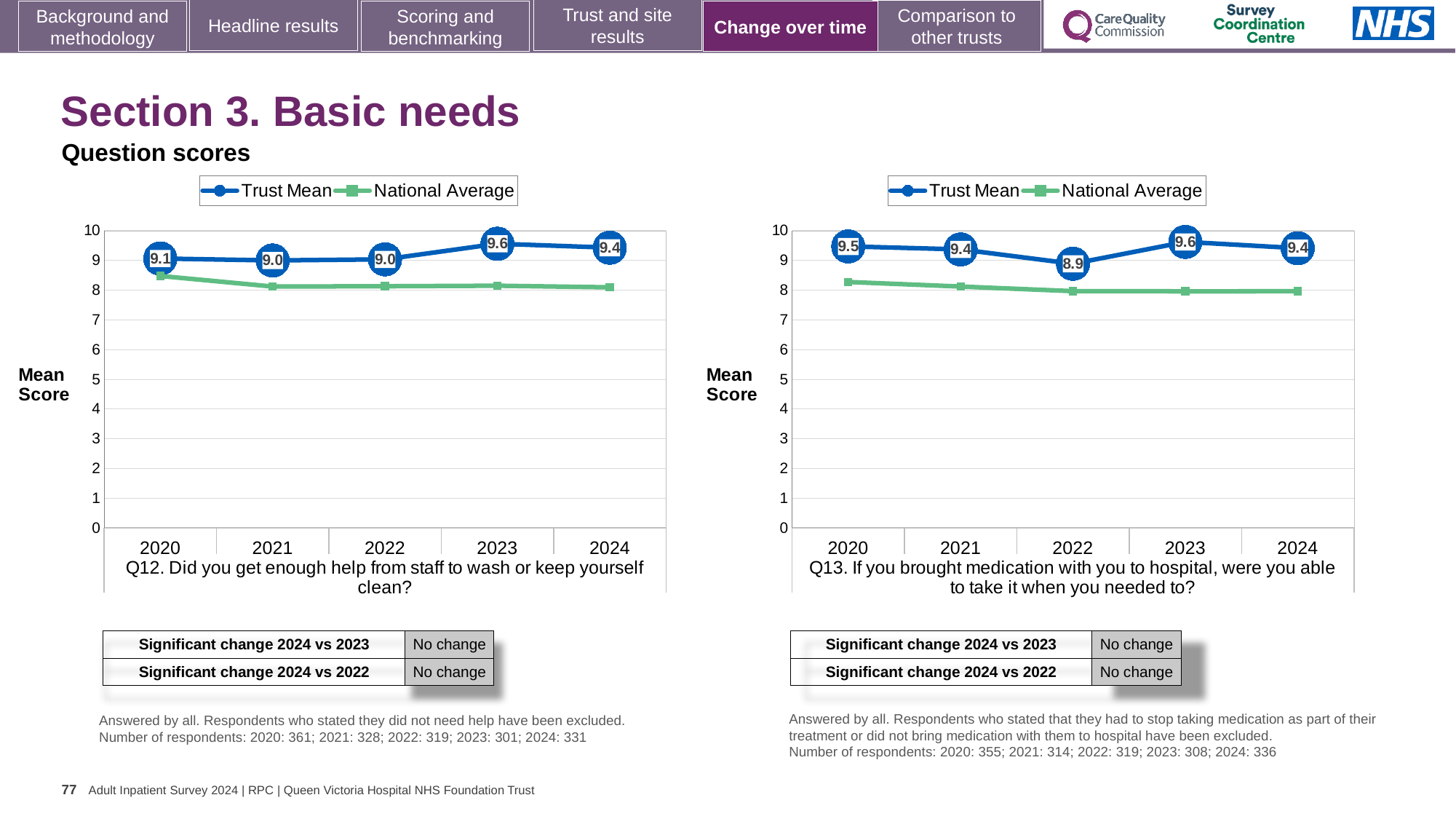
What type of chart is the Q13 chart (right)? Line chart In the Q12 chart (left), which year has the highest Trust Mean? 2023 In the Q13 chart (right), what is the Trust Mean for 2022? 8.9 How many series does the legend of the Q12 chart (left) list? 2 In the Q12 chart (left), what is the Trust Mean for 2020? 9.1 In the Q12 chart (left), what is the Trust Mean for 2023? 9.6 In the Q13 chart (right), what is the Trust Mean for 2024? 9.4 In the Q12 chart (left), is the Trust Mean for 2023 or for 2021 larger? 2023 In the Q13 chart (right), which year has the lowest Trust Mean? 2022 In the Q13 chart (right), what is the difference between the Trust Mean for 2023 and the Trust Mean for 2022? 0.7 In the Q12 chart (left), is the National Average for 2024 greater or less than 9? less How many years are plotted on the x axis of the Q13 chart (right)? 5